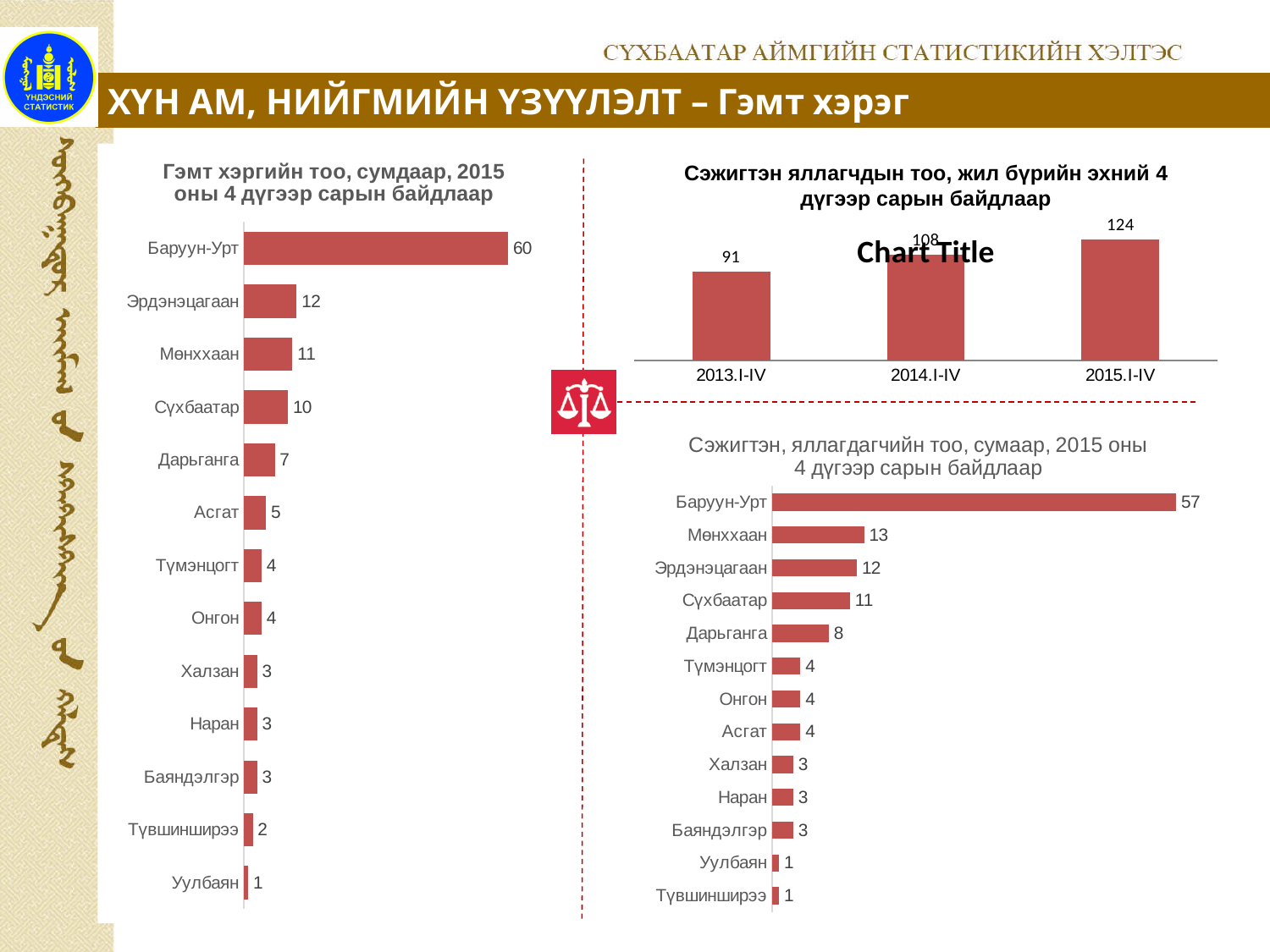
In the left chart 'Гэмт хэргийн тоо, сумдаар', how many categories are shown? 13 What kind of chart is the top right chart 'Сэжигтэн яллагчдын тоо'? bar chart In the top right chart 'Сэжигтэн яллагчдын тоо', do the values rise or fall from 2013.I-IV to 2015.I-IV? rise In the bottom right chart 'Сэжигтэн, яллагдагчийн тоо, сумаар', which category has the highest value? Баруун-Урт In the left chart 'Гэмт хэргийн тоо, сумдаар', which is larger, the value for Дарьганга or the value for Асгат? Дарьганга In the bottom right chart 'Сэжигтэн, яллагдагчийн тоо, сумаар, 2015 оны 4 дүгээр сарын байдлаар', what is the value for Мөнххаан? 13 In the left chart 'Гэмт хэргийн тоо, сумдаар', what is the difference between the values for Эрдэнэцагаан and Сүхбаатар? 2 In the left chart 'Гэмт хэргийн тоо, сумдаар, 2015 оны 4 дүгээр сарын байдлаар', what is the value for Баруун-Урт? 60 In the bottom right chart 'Сэжигтэн, яллагдагчийн тоо, сумаар', what is the value for Дарьганга? 8 In the top right chart 'Сэжигтэн яллагчдын тоо, жил бүрийн эхний 4 дүгээр сарын байдлаар', what is the value for 2014.I-IV? 108 In the top right chart 'Сэжигтэн яллагчдын тоо', what is the difference between the values for 2015.I-IV and 2013.I-IV? 33 In the left chart 'Гэмт хэргийн тоо, сумдаар', which category has the lowest value? Уулбаян